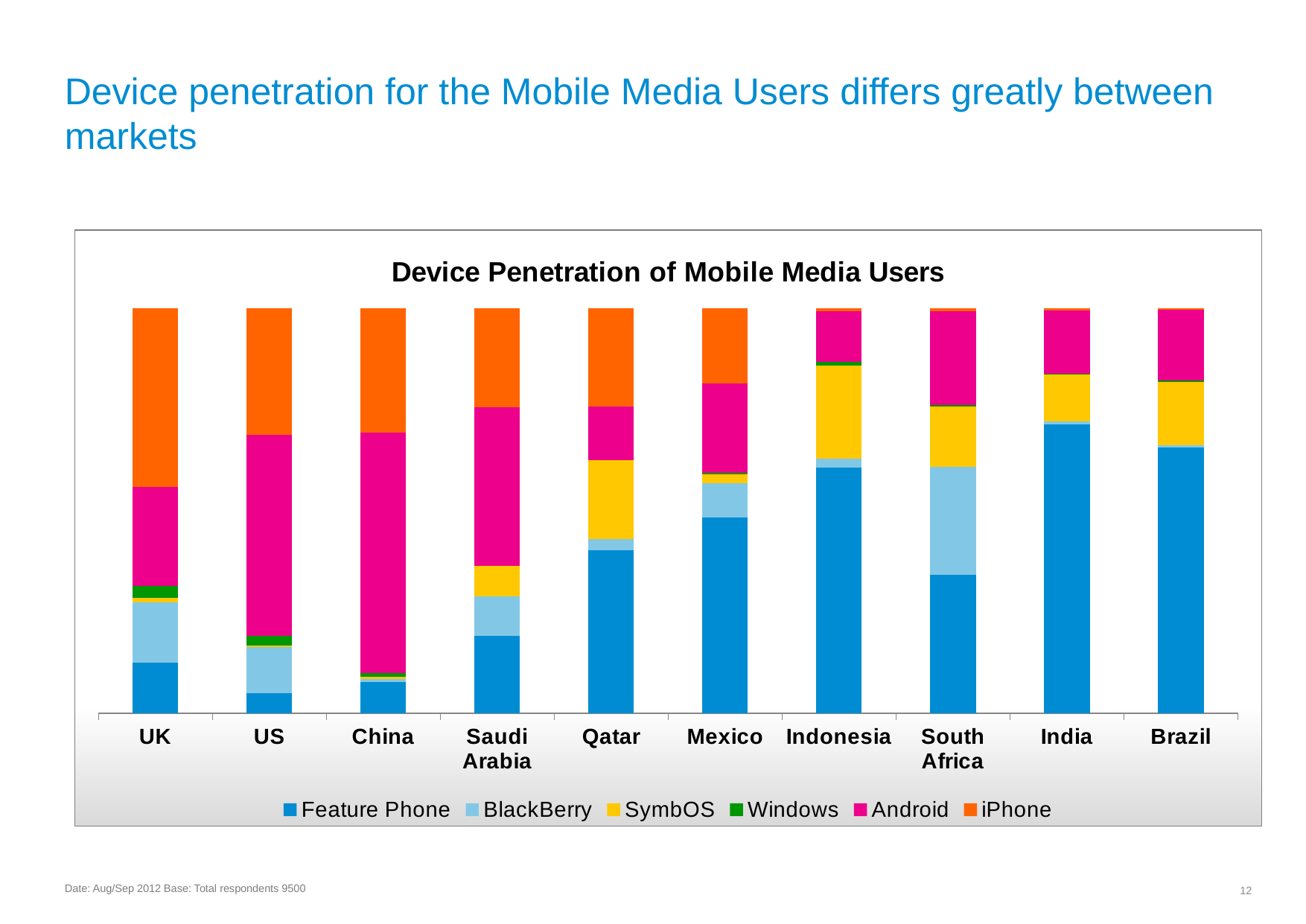
How many countries are shown on the x axis of the chart? 10 Which country has the largest Android share in the chart? China Which has the larger BlackBerry share, South Africa or Qatar? South Africa Which has the larger iPhone share, UK or Brazil? UK What kind of chart is shown on the slide? Stacked bar chart What is the title of the chart? Device Penetration of Mobile Media Users How many series does the chart legend list? 6 Which series is shown in orange in the chart? iPhone Which has the larger Android share, China or UK? China Which country has the largest BlackBerry share in the chart? South Africa Which country has the largest iPhone share in the chart? UK